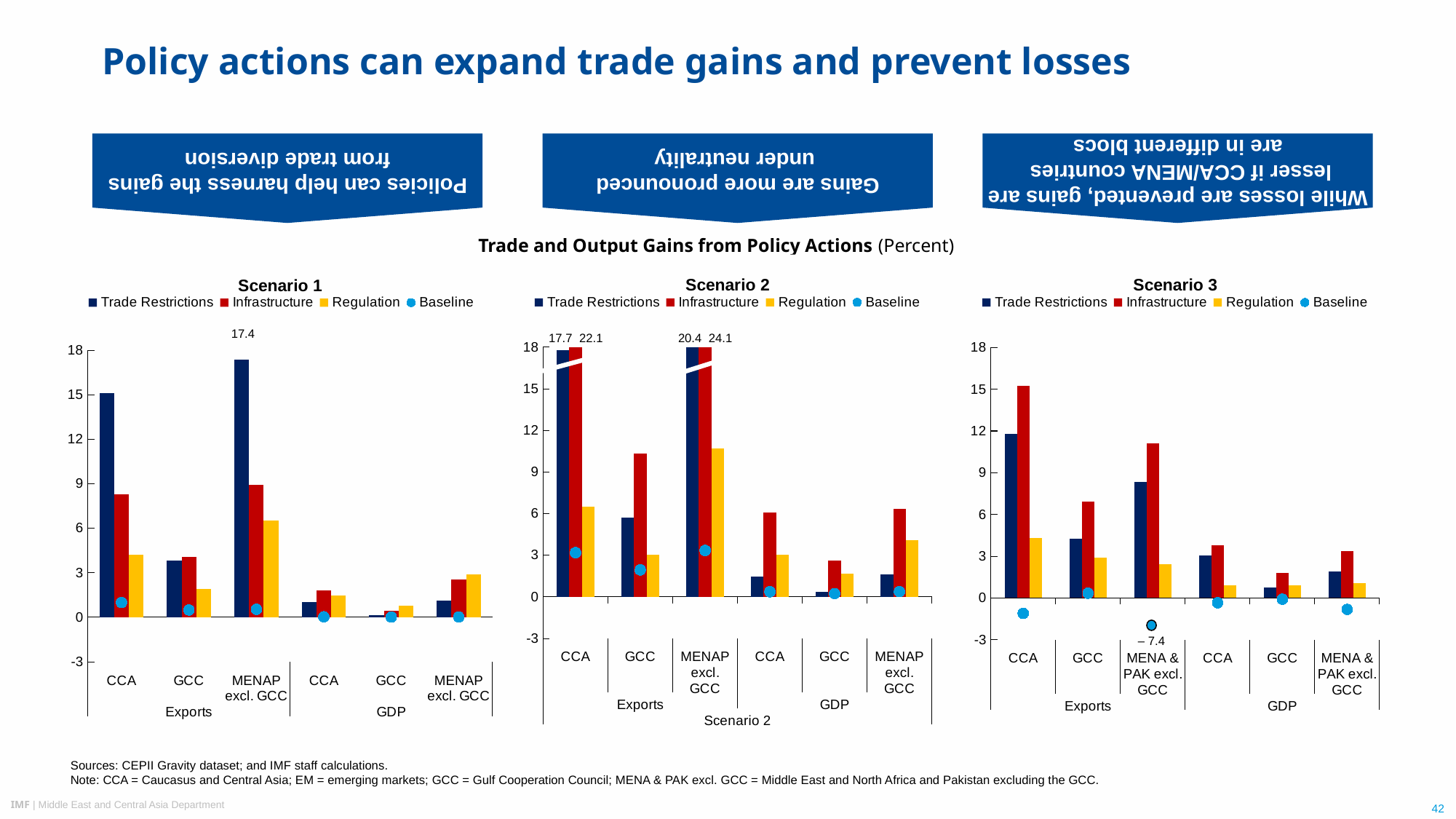
What is the overall title shown above the three charts? Trade and Output Gains from Policy Actions (Percent) How many series does the legend of the Scenario 1 chart list? 4 In the Scenario 1 chart, what is the Trade Restrictions value for MENAP excl. GCC under Exports? 17.4 In the Scenario 2 chart, what is the difference between the Infrastructure and Trade Restrictions values for CCA under Exports? 4.4 In the Scenario 2 chart, what is the Trade Restrictions value for MENAP excl. GCC under Exports? 20.4 In the Scenario 2 chart, what is the Infrastructure value for CCA under Exports? 22.1 What kind of chart is the Scenario 3 chart? Bar chart In the Scenario 1 chart, is the Trade Restrictions value for CCA under Exports greater or less than 12? greater In the Scenario 3 chart, which series has the highest value for CCA under Exports? Infrastructure In the Scenario 3 chart, what is the Baseline value for MENA & PAK excl. GCC under Exports? – 7.4 In the Scenario 1 chart, which is larger for CCA under Exports: Trade Restrictions or Infrastructure? Trade Restrictions In the Scenario 2 chart, what is the difference between the Infrastructure and Trade Restrictions values for MENAP excl. GCC under Exports? 3.7